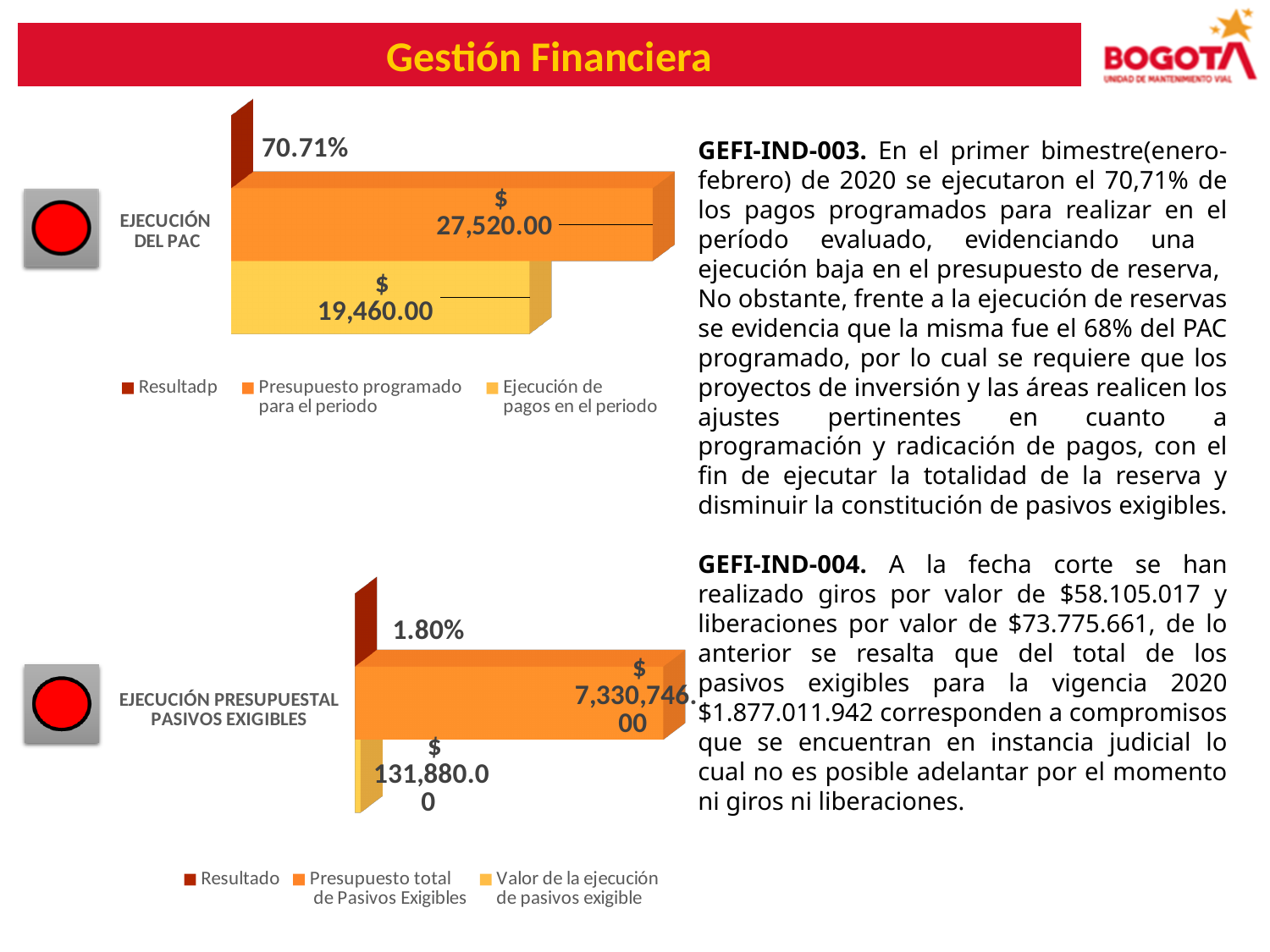
How many series does the legend of the EJECUCIÓN DEL PAC chart list? 3 What colour is the Presupuesto total de Pasivos Exigibles series in the EJECUCIÓN PRESUPUESTAL PASIVOS EXIGIBLES chart? Orange In the EJECUCIÓN DEL PAC chart, what value is shown for Ejecución de pagos en el periodo? $ 19,460.00 In the EJECUCIÓN DEL PAC chart, what is the difference between Presupuesto programado para el periodo and Ejecución de pagos en el periodo? $ 8,060.00 In the EJECUCIÓN PRESUPUESTAL PASIVOS EXIGIBLES chart, which is larger: Presupuesto total de Pasivos Exigibles or Valor de la ejecución de pasivos exigible? Presupuesto total de Pasivos Exigibles What kind of chart is the EJECUCIÓN DEL PAC chart? Bar chart In the EJECUCIÓN PRESUPUESTAL PASIVOS EXIGIBLES chart, what value is shown for Valor de la ejecución de pasivos exigible? $ 131,880.00 In the EJECUCIÓN DEL PAC chart, which is larger: Presupuesto programado para el periodo or Ejecución de pagos en el periodo? Presupuesto programado para el periodo In the EJECUCIÓN PRESUPUESTAL PASIVOS EXIGIBLES chart, what percentage is shown for the Resultado series? 1.80% In the EJECUCIÓN DEL PAC chart, what percentage is shown for the Resultadp series? 70.71% In the EJECUCIÓN PRESUPUESTAL PASIVOS EXIGIBLES chart, what value is shown for Presupuesto total de Pasivos Exigibles? $ 7,330,746.00 In the EJECUCIÓN DEL PAC chart, what value is shown for Presupuesto programado para el periodo? $ 27,520.00